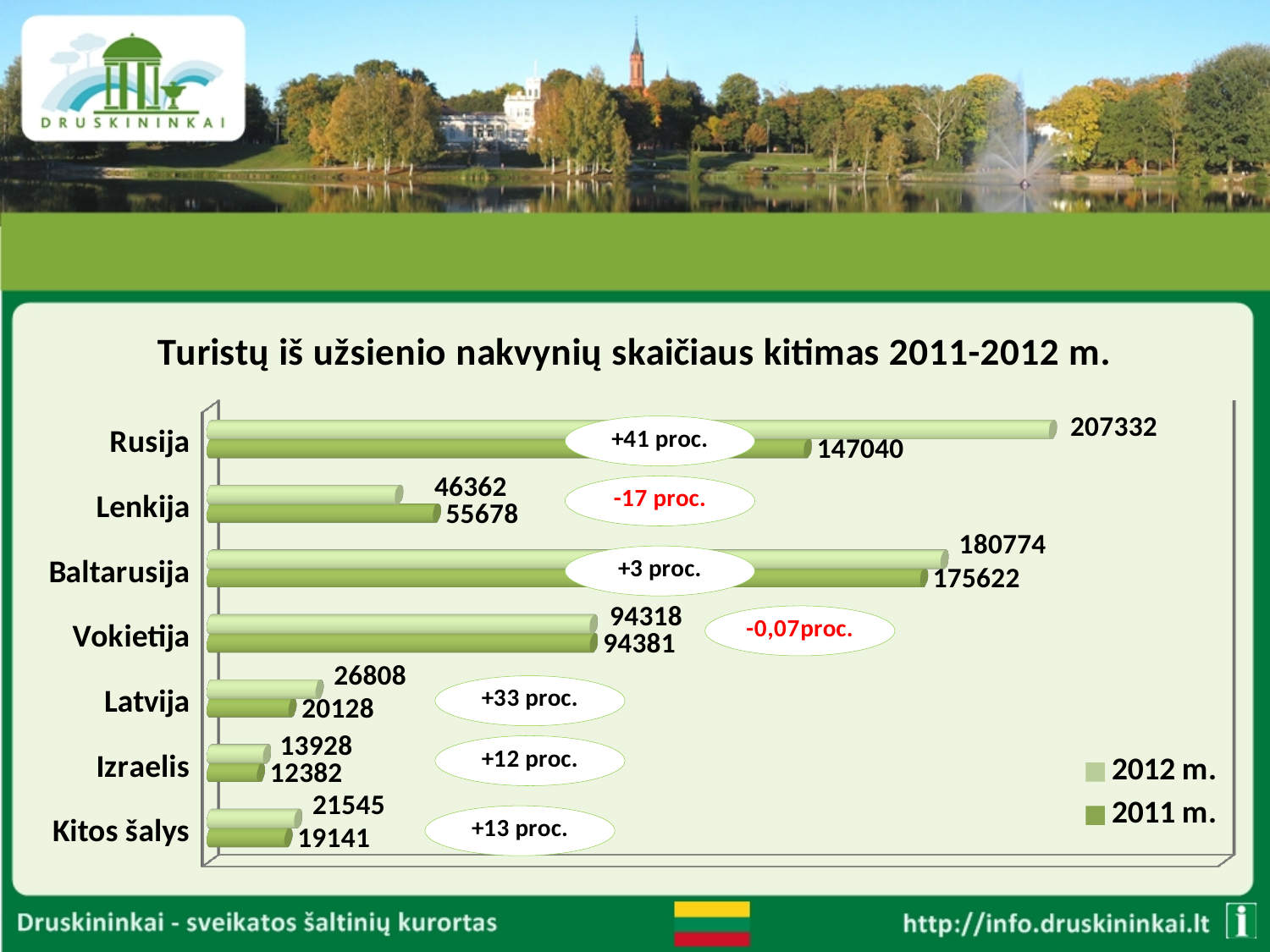
What is the difference between the 2012 m. and 2011 m. values for Rusija? 60292 What percentage change is shown for Lenkija? -17 proc. Which category has the lowest 2011 m. value? Izraelis How many series does the legend list? 2 What is the 2012 m. value for Rusija? 207332 Which category has the highest 2012 m. value? Rusija What is the 2012 m. value for Baltarusija? 180774 What is the 2011 m. value for Latvija? 20128 What kind of chart is shown on the slide? Bar chart Which is larger for Lenkija, the 2012 m. value or the 2011 m. value? 2011 m. What is the 2011 m. value for Lenkija? 55678 How many categories are shown on the chart? 7